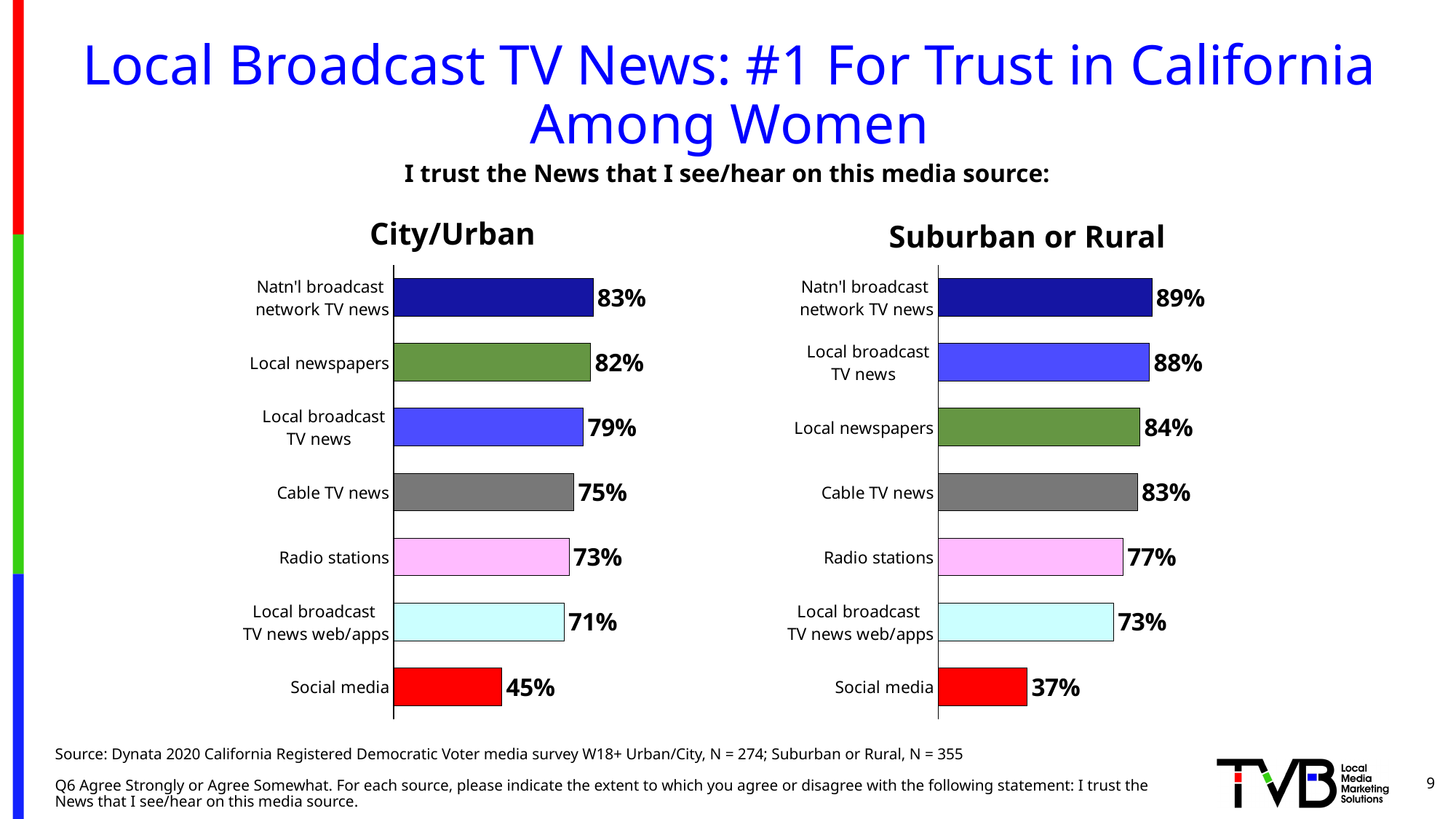
In the City/Urban chart, what is the value for Local broadcast TV news? 79% In the Suburban or Rural chart, which media source has the highest value? Natn'l broadcast network TV news In the Suburban or Rural chart, what is the value for Local newspapers? 84% Is the value for Social media in the Suburban or Rural chart greater or less than the value for Social media in the City/Urban chart? less In the Suburban or Rural chart, what is the difference between Local broadcast TV news and Social media? 51% In the City/Urban chart, what is the difference between Cable TV news and Radio stations? 2% In the Suburban or Rural chart, what is the value for Radio stations? 77% In the City/Urban chart, which media source has the lowest value? Social media What colour is the Social media bar in the City/Urban chart? red What kind of chart is the Suburban or Rural chart? bar chart In the City/Urban chart, which is larger: Local newspapers or Local broadcast TV news web/apps? Local newspapers How many media sources are shown in the City/Urban chart? 7